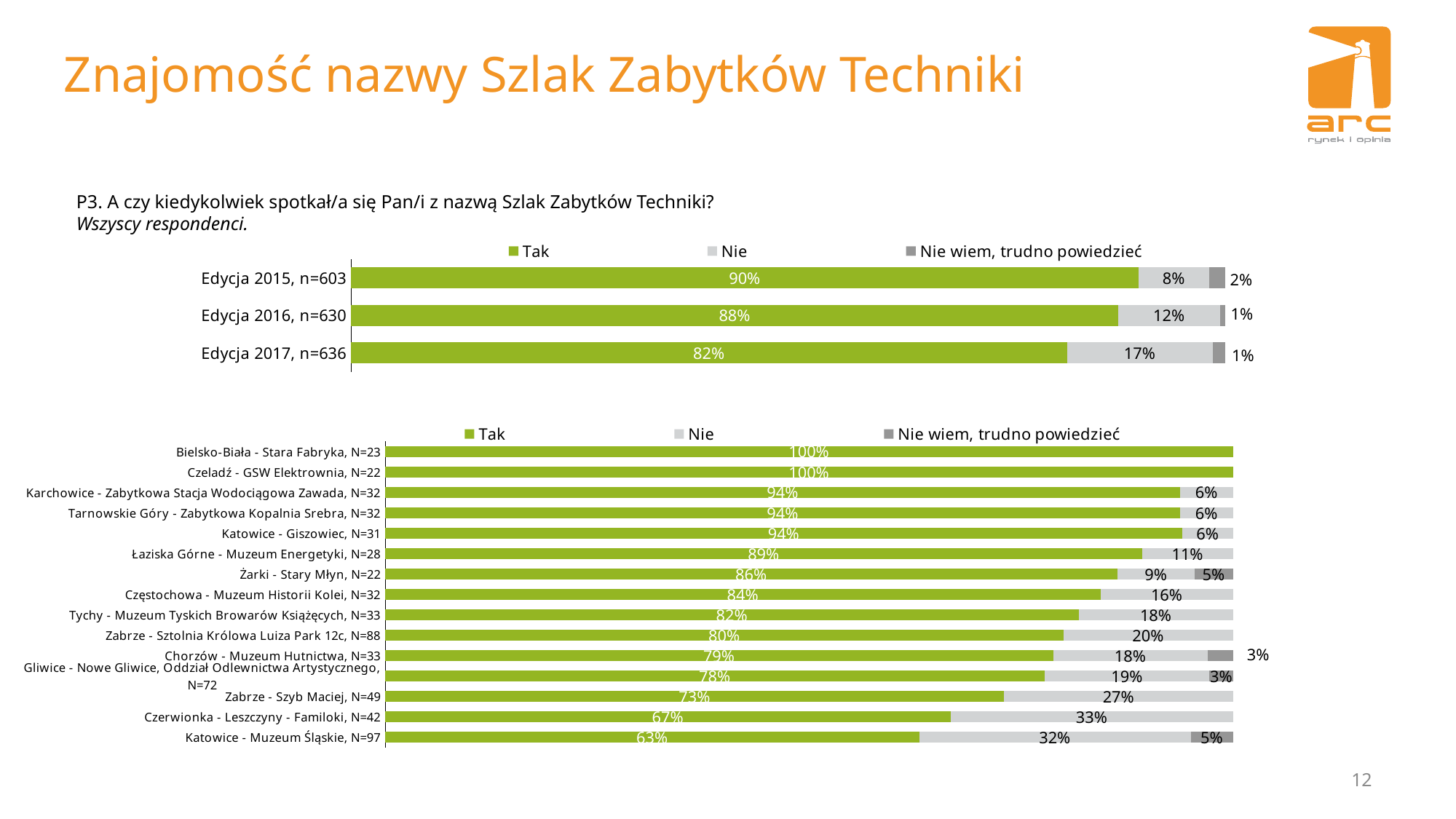
In the bottom chart, which location has the lowest 'Tak' value? Katowice - Muzeum Śląskie, N=97 In the bottom chart, what is the 'Tak' value for Katowice - Muzeum Śląskie, N=97? 63% What type of chart is the bottom chart? Stacked bar chart In the top chart, what is the 'Nie' value for Edycja 2017, n=636? 17% In the top chart, how does the 'Tak' share change from Edycja 2015 to Edycja 2017? It falls In the top chart, how many series does the legend list? 3 In the top chart, what is the difference between the 'Tak' values for Edycja 2015 and Edycja 2017? 8 percentage points In the bottom chart, how many locations are listed? 15 In the top chart, what is the 'Nie wiem, trudno powiedzieć' value for Edycja 2016, n=630? 1% In the bottom chart, what is the 'Nie' value for Czerwionka - Leszczyny - Familoki, N=42? 33% In the top chart, what is the 'Tak' value for Edycja 2015, n=603? 90% In the bottom chart, which is larger: the 'Tak' value for Tychy - Muzeum Tyskich Browarów Książęcych, N=33 or for Zabrze - Szyb Maciej, N=49? Tychy - Muzeum Tyskich Browarów Książęcych, N=33